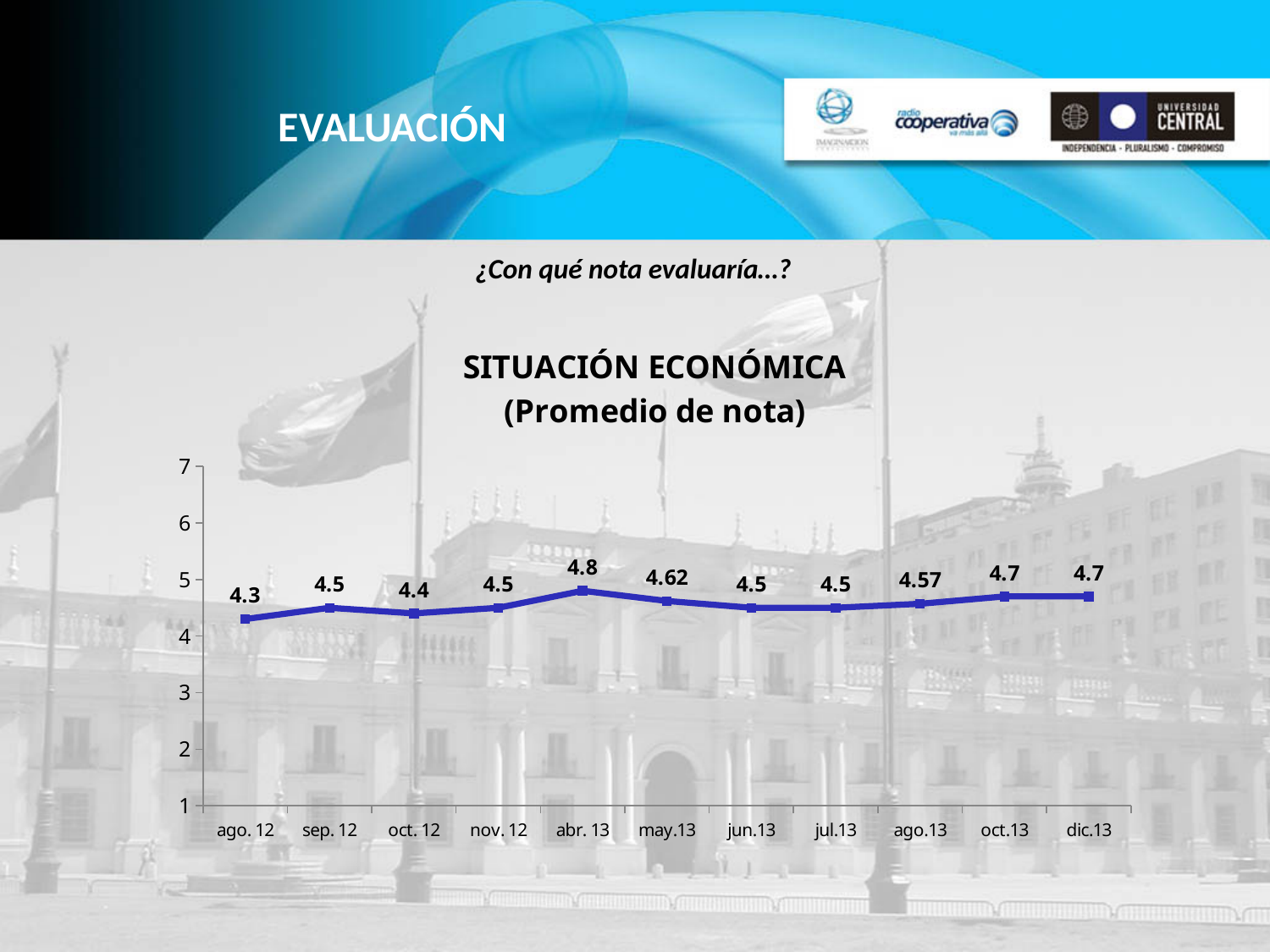
What type of chart is shown on the slide? line chart How many periods are plotted on the x axis? 11 Which period has the lowest value? ago. 12 What is the difference between the value for abr. 13 and the value for ago. 12? 0.5 Which period has the highest value? abr. 13 Which is larger, the value for may.13 or the value for ago.13? may.13 What is the title of the chart? SITUACIÓN ECONÓMICA (Promedio de nota) Is the value for abr. 13 greater or less than 5? less What is the value for may.13? 4.62 What is the value for ago.13? 4.57 What is the value for dic.13? 4.7 What is the value for ago. 12? 4.3